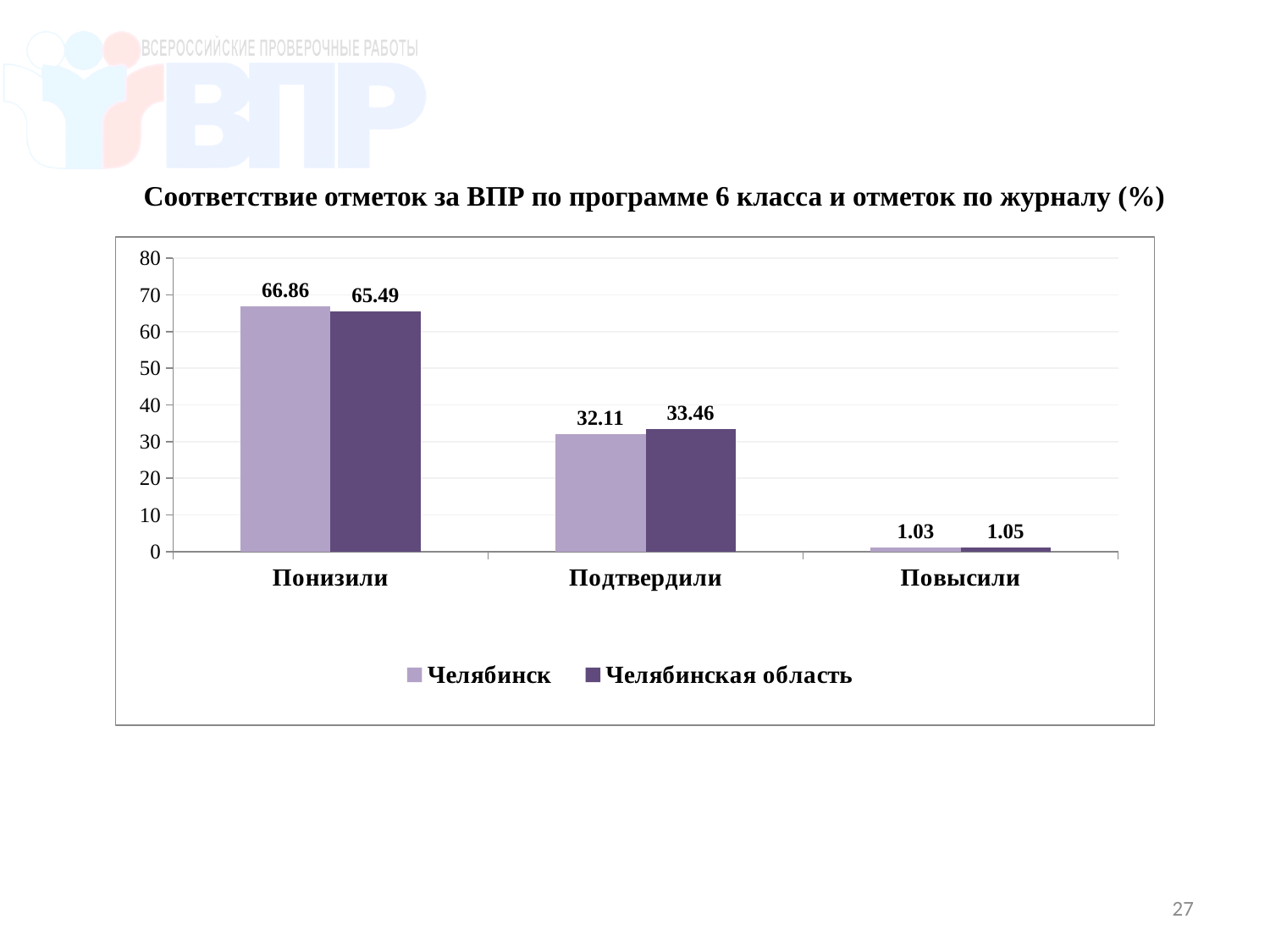
Which category has the lowest value for Челябинск? Повысили What is the value for Челябинск in the Повысили category? 1.03 Which category has the highest value for Челябинская область? Понизили What kind of chart is shown on the slide? bar chart How many series does the legend list? 2 Is the value for Челябинская область in the Понизили category greater or less than 60? greater What is the title of the chart? Соответствие отметок за ВПР по программе 6 класса и отметок по журналу (%) How many categories are shown on the x axis? 3 What is the value for Челябинск in the Понизили category? 66.86 In the Подтвердили category, which series has the larger value: Челябинск or Челябинская область? Челябинская область What is the value for Челябинская область in the Подтвердили category? 33.46 What is the difference between the Челябинск and Челябинская область values in the Понизили category? 1.37